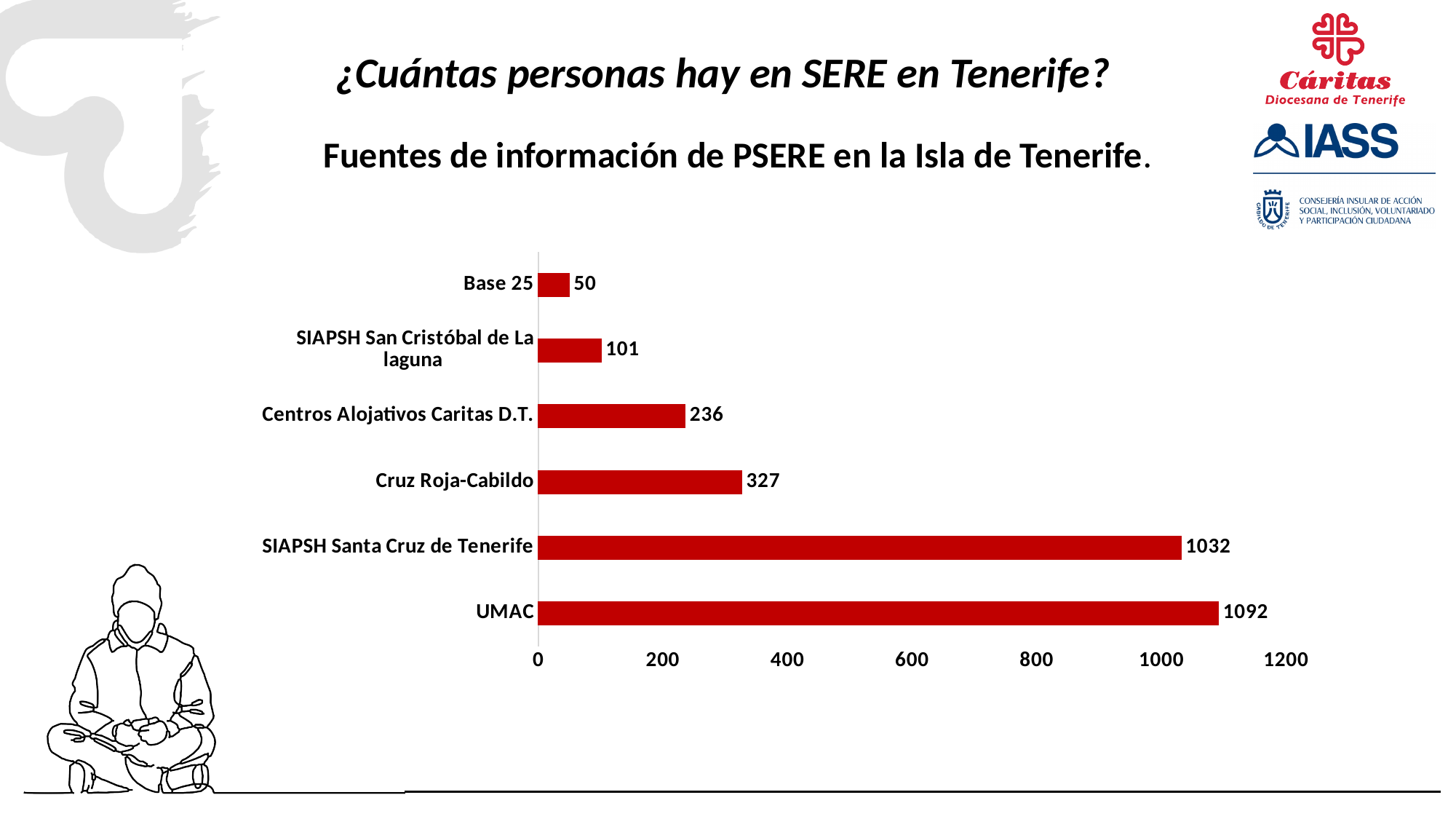
How many categories are shown in the chart? 6 Which category has the highest value? UMAC What is the difference between the values for SIAPSH San Cristóbal de La laguna and Base 25? 51 What is the difference between the values for UMAC and SIAPSH Santa Cruz de Tenerife? 60 Which is larger, the value for Cruz Roja-Cabildo or the value for Centros Alojativos Caritas D.T.? Cruz Roja-Cabildo What is the value for UMAC? 1092 What kind of chart is shown on the slide? Bar chart What is the value for Base 25? 50 What is the value for Cruz Roja-Cabildo? 327 What is the value for Centros Alojativos Caritas D.T.? 236 What is the value for SIAPSH Santa Cruz de Tenerife? 1032 Which category has the lowest value? Base 25